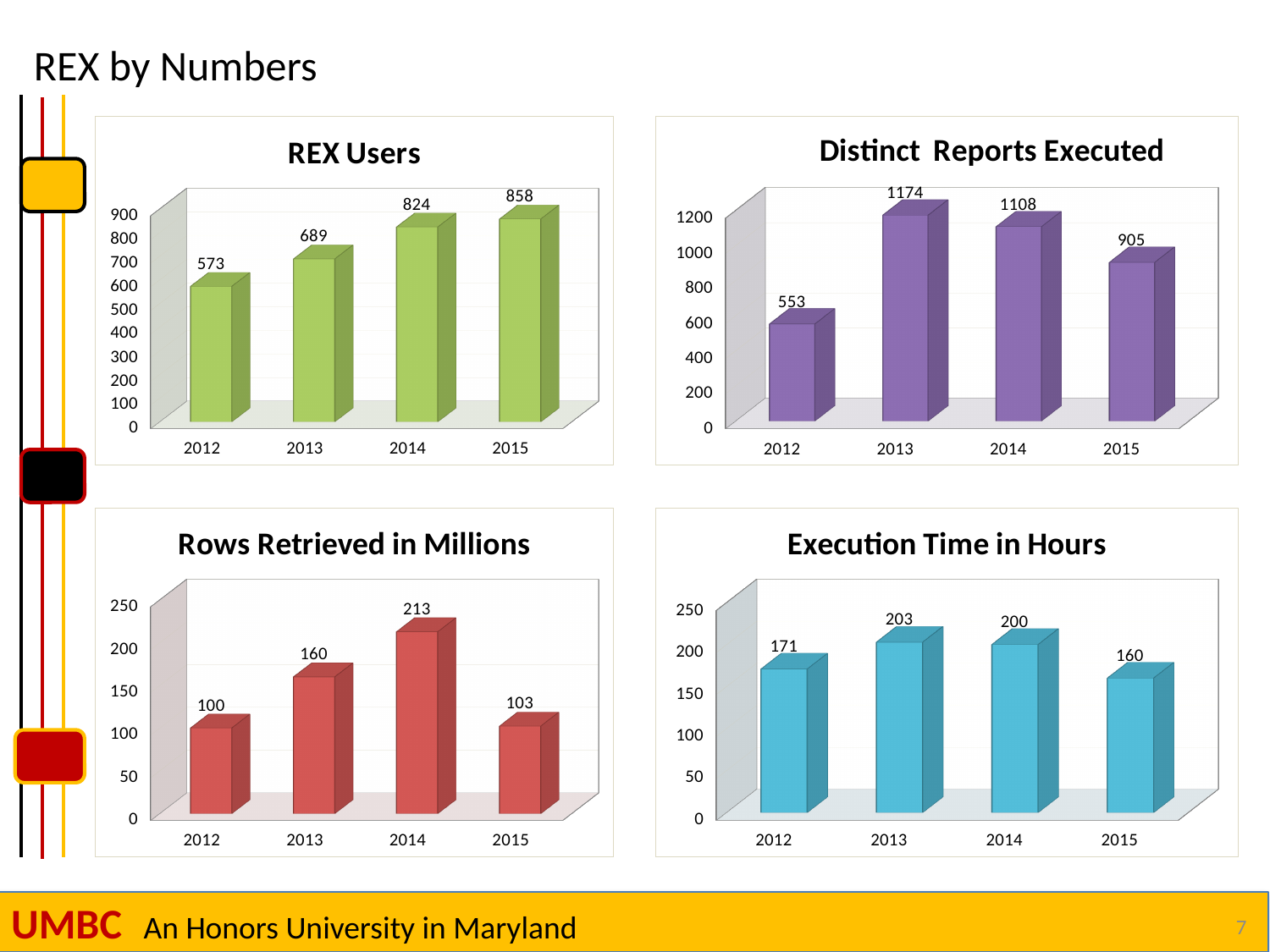
How many years are shown on the x axis of the 'Execution Time in Hours' chart? 4 In the 'Distinct Reports Executed' chart, which year has the lowest value? 2012 In the 'Distinct Reports Executed' chart, what is the value for 2014? 1108 In the 'Rows Retrieved in Millions' chart, what is the difference between the 2014 and 2015 values? 110 What kind of chart is the 'Rows Retrieved in Millions' chart? Bar chart In the 'REX Users' chart, which year has the highest value? 2015 In the 'REX Users' chart, what is the value for 2013? 689 In the 'REX Users' chart, what is the difference between the 2015 and 2012 values? 285 In the 'Rows Retrieved in Millions' chart, what is the value for 2014? 213 In the 'Execution Time in Hours' chart, what is the value for 2012? 171 In the 'Distinct Reports Executed' chart, which is larger, the value for 2013 or the value for 2015? 2013 In the 'Execution Time in Hours' chart, which year has the lowest value? 2015